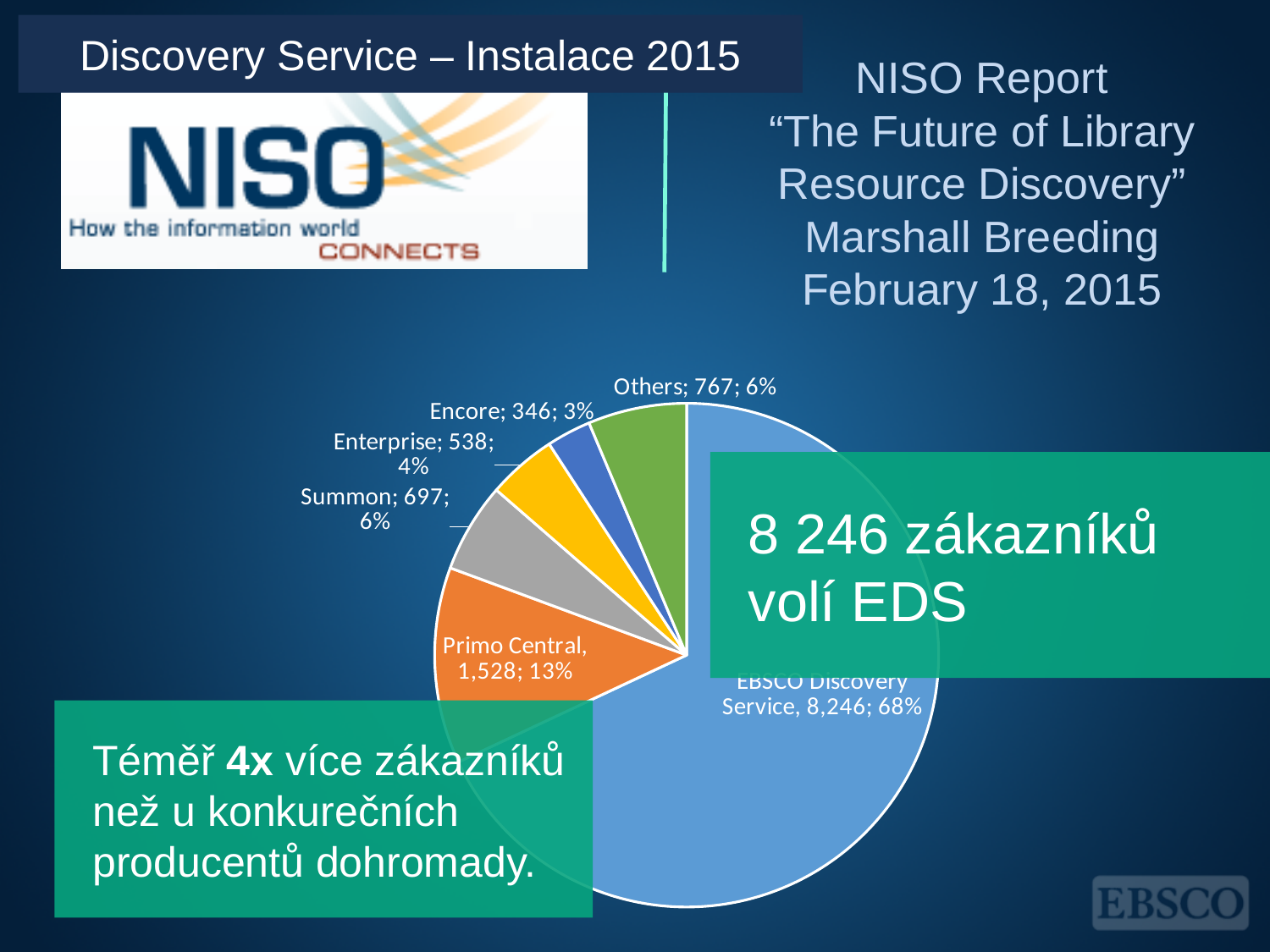
What share of the pie does EBSCO Discovery Service have? 68% Which has a larger value, Enterprise or Others? Others What is the value for Enterprise in the pie chart? 538 What share of the pie does Encore have? 3% What kind of chart is shown on the slide? pie chart What is the difference between the values for Primo Central and Summon? 831 What is the value for EBSCO Discovery Service in the pie chart? 8,246 Which slice of the pie chart is the largest? EBSCO Discovery Service Which slice of the pie chart is the smallest? Encore What is the value for Summon in the pie chart? 697 How many slices does the pie chart have? 6 What share of the pie does Primo Central have? 13%